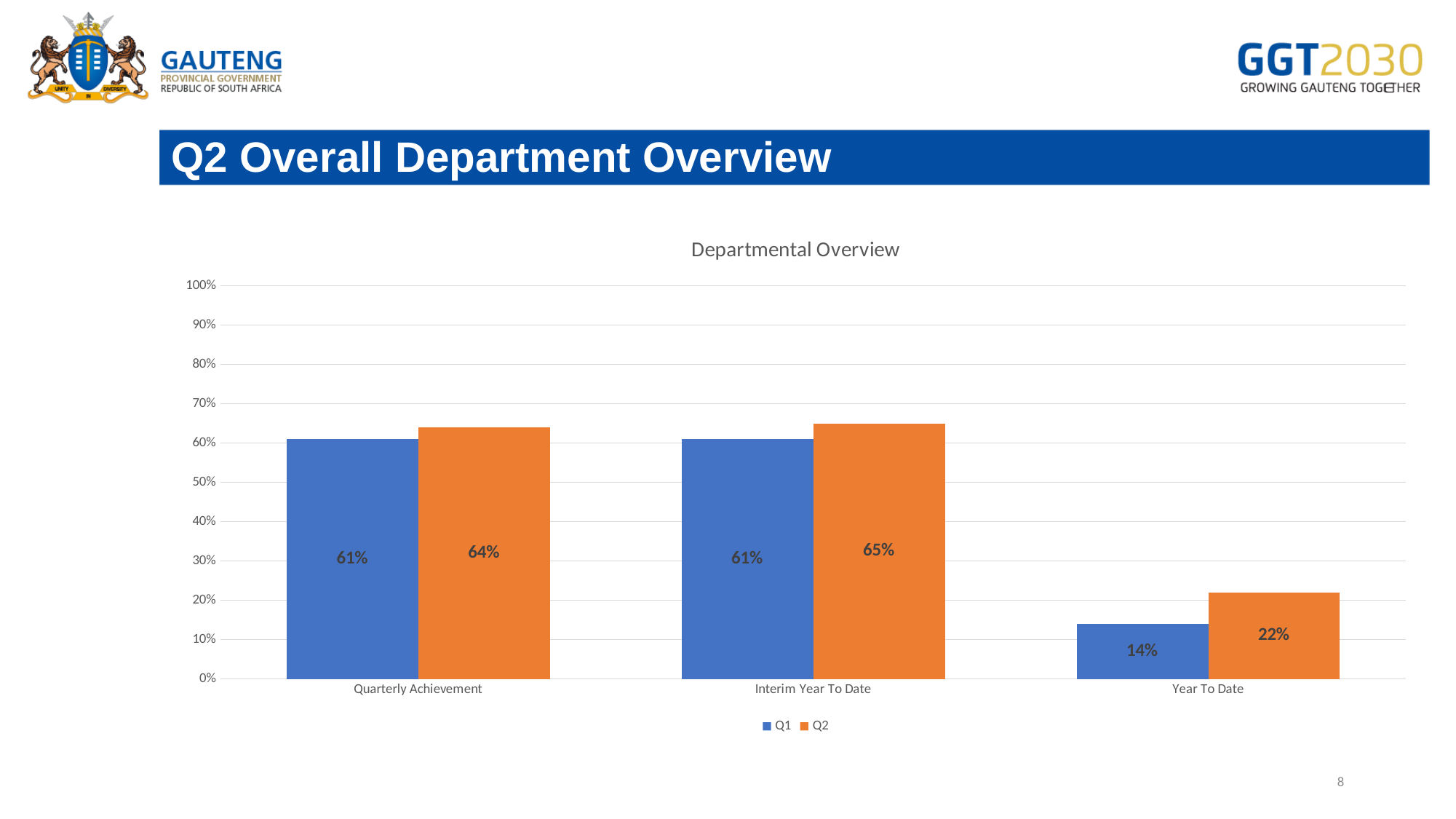
Which category has the highest Q2 value? Interim Year To Date What is the Q1 value for Quarterly Achievement? 61% Which is larger for Interim Year To Date, the Q1 value or the Q2 value? Q2 What is the Q1 value for Year To Date? 14% What is the difference between the Q2 and Q1 values for Year To Date? 8% How many series does the legend list? 2 What is the difference between the Q2 and Q1 values for Quarterly Achievement? 3% How many categories are shown on the x axis? 3 What is the Q2 value for Interim Year To Date? 65% Which category has the lowest Q1 value? Year To Date What is the Q2 value for Year To Date? 22% What type of chart is shown on the slide? Bar chart